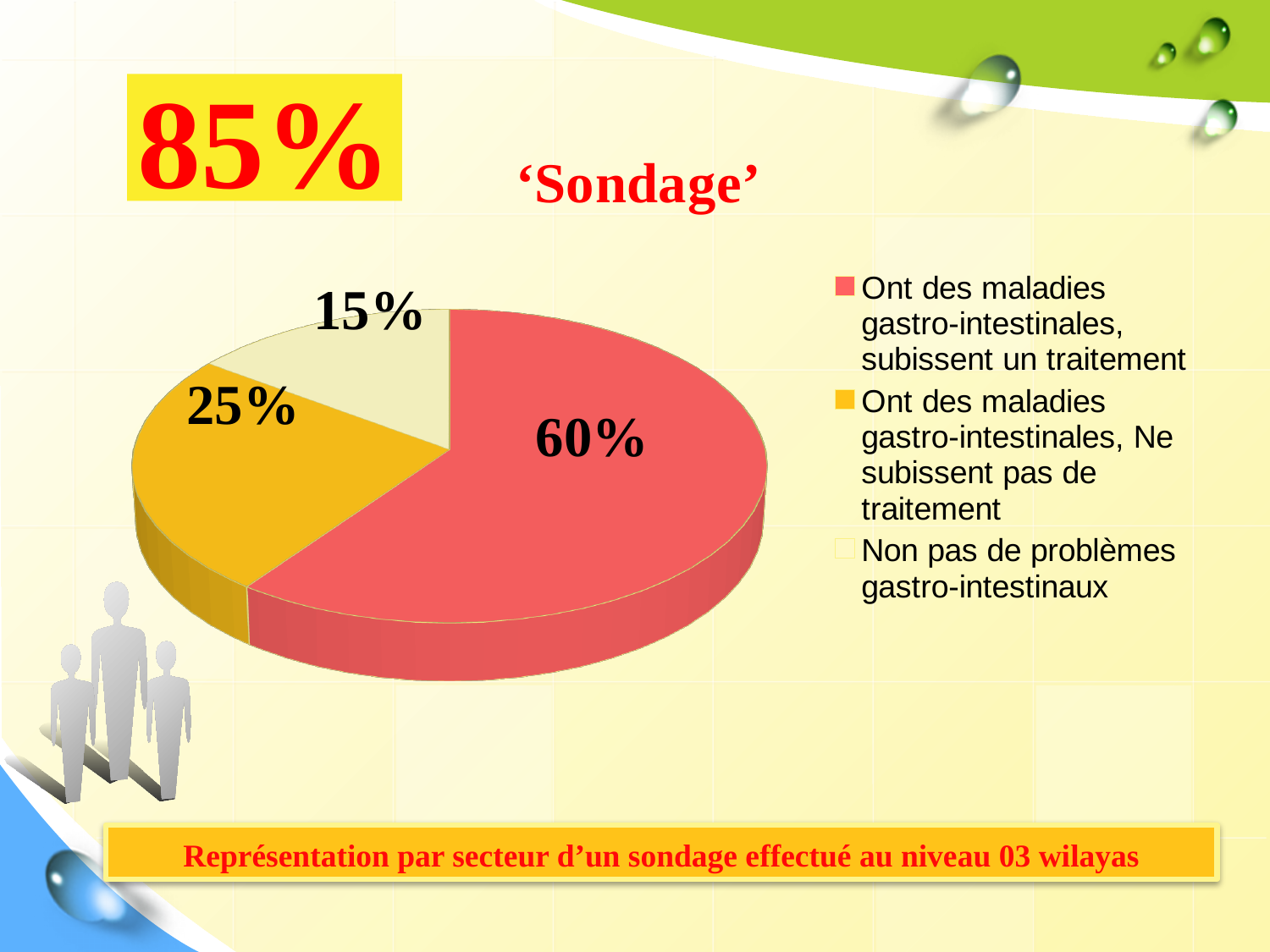
Which is larger: the slice for those who undergo treatment or the slice for those who do not undergo treatment? Those who undergo treatment (60%) What is the difference between the 25% slice and the 15% slice? 10% Which category has the largest slice of the pie? Ont des maladies gastro-intestinales, subissent un traitement What share of the pie corresponds to 'Ont des maladies gastro-intestinales, subissent un traitement'? 60% What colour is the slice representing 'Non pas de problèmes gastro-intestinaux'? Cream (pale yellow) What share of the pie corresponds to 'Ont des maladies gastro-intestinales, Ne subissent pas de traitement'? 25% Which category has the smallest slice of the pie? Non pas de problèmes gastro-intestinaux What share of the pie corresponds to 'Non pas de problèmes gastro-intestinaux'? 15% What kind of chart is shown on the slide? Pie chart What is the title shown above the pie chart? 'Sondage' What is the difference between the largest slice and the smallest slice of the pie? 45% How many slices does the pie chart have? 3